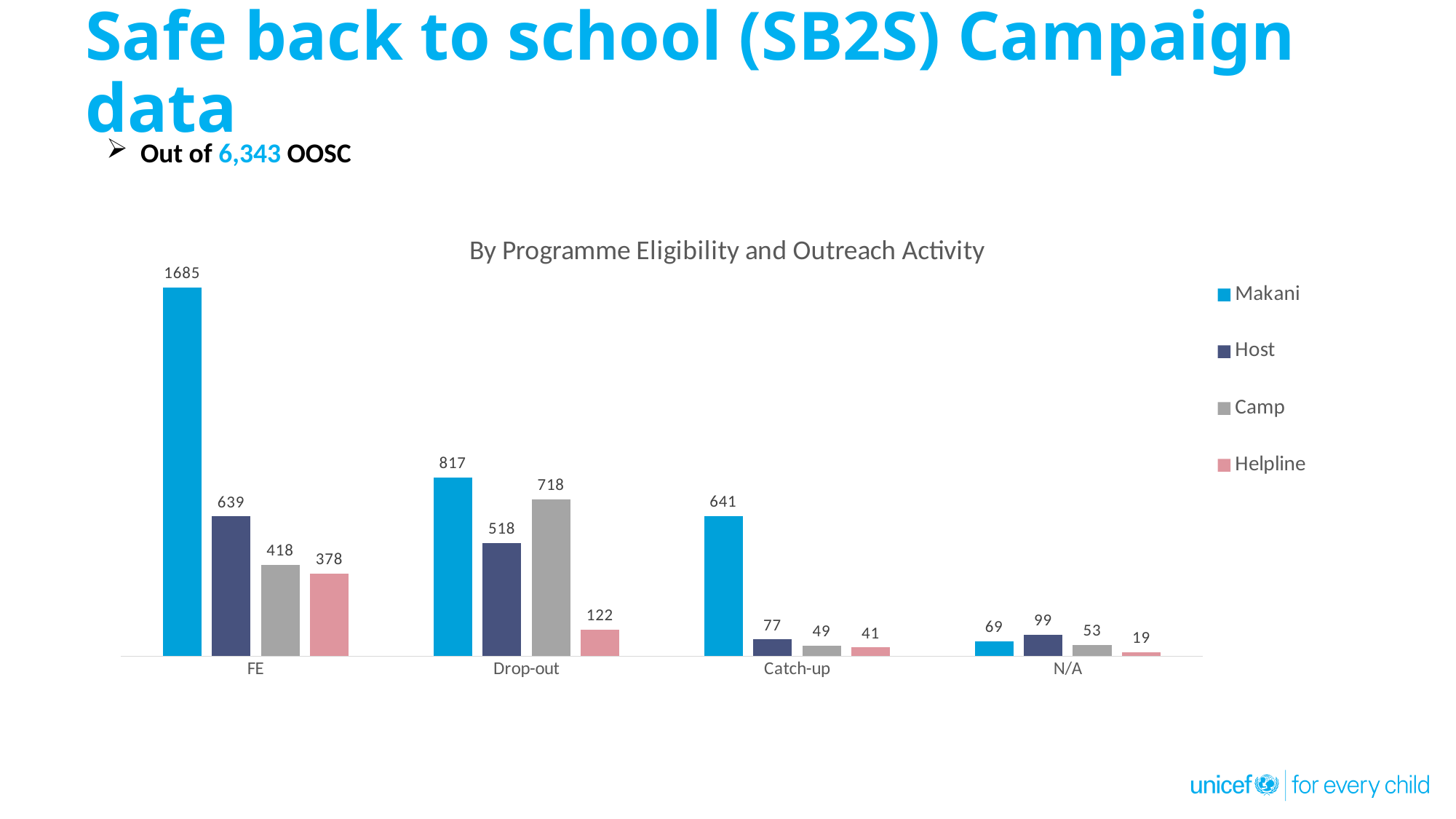
Which is larger for Drop-out, the Host value or the Camp value? Camp What is the Helpline value for Catch-up? 41 How many categories are shown on the x axis? 4 What is the Makani value for FE? 1685 Which category has the lowest Helpline value? N/A What is the Host value for N/A? 99 Which category has the highest Makani value? FE What kind of chart is shown? Bar chart What is the Camp value for Drop-out? 718 What is the difference between the Makani and Host values for FE? 1046 What is the title of the chart? By Programme Eligibility and Outreach Activity How many series does the legend list? 4